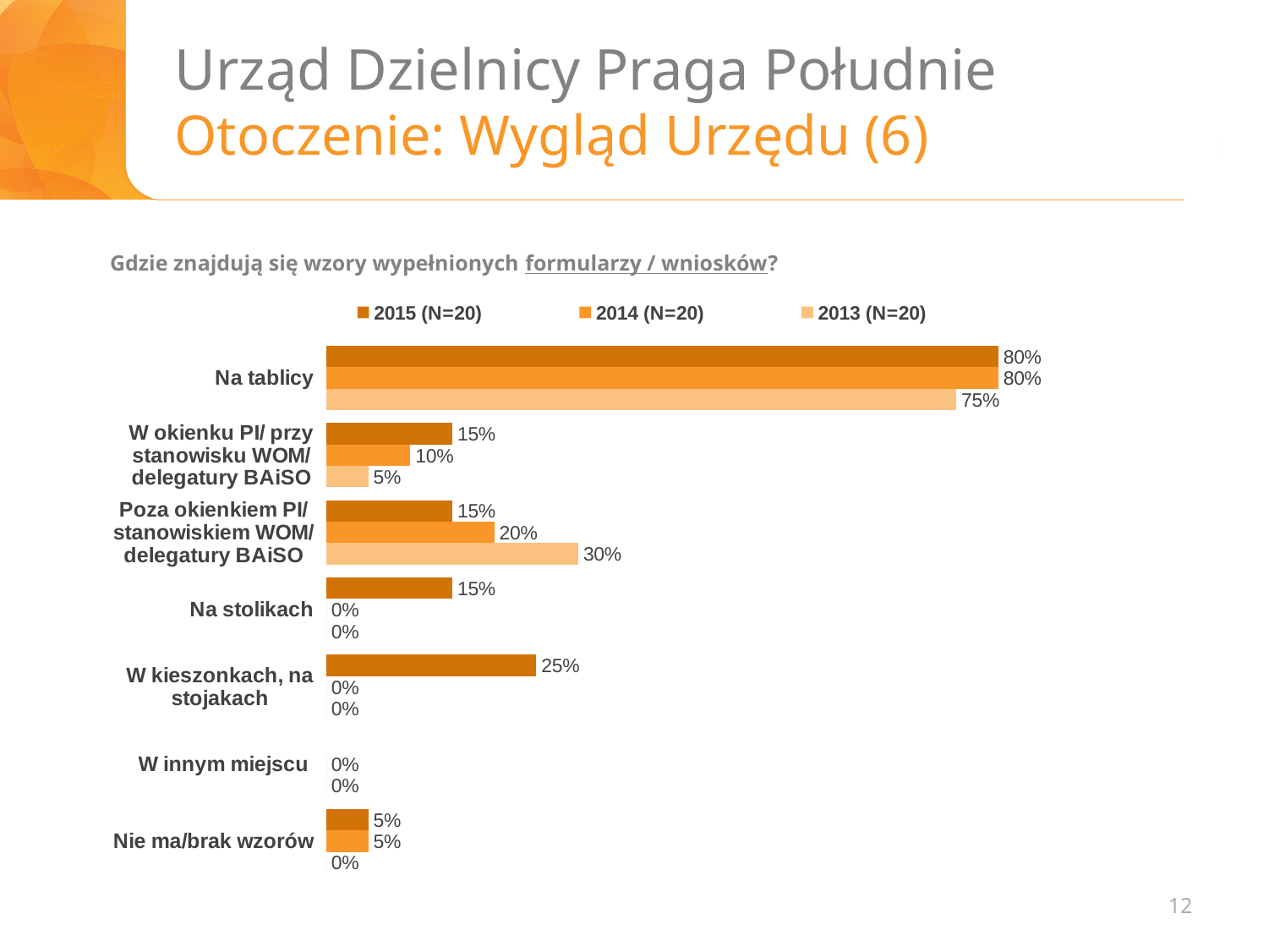
What is the value for 'W okienku PI/ przy stanowisku WOM/ delegatury BAiSO' in the 2014 (N=20) series? 10% What is the value for 'Nie ma/brak wzorów' in the 2013 (N=20) series? 0% For 'Poza okienkiem PI/ stanowiskiem WOM/ delegatury BAiSO', which series has the larger value: 2015 (N=20) or 2013 (N=20)? 2013 (N=20) How many series does the legend list? 3 How many categories are shown on the chart? 7 What question is the chart about, as stated above it? Gdzie znajdują się wzory wypełnionych formularzy / wniosków? What kind of chart is shown on the slide? bar chart What is the value for 'W kieszonkach, na stojakach' in the 2015 (N=20) series? 25% What is the value for 'Poza okienkiem PI/ stanowiskiem WOM/ delegatury BAiSO' in the 2013 (N=20) series? 30% Which category has the highest value in the 2015 (N=20) series? Na tablicy What is the value for 'Na tablicy' in the 2013 (N=20) series? 75% What is the difference between the 2015 (N=20) and 2013 (N=20) values for 'Na tablicy'? 5%